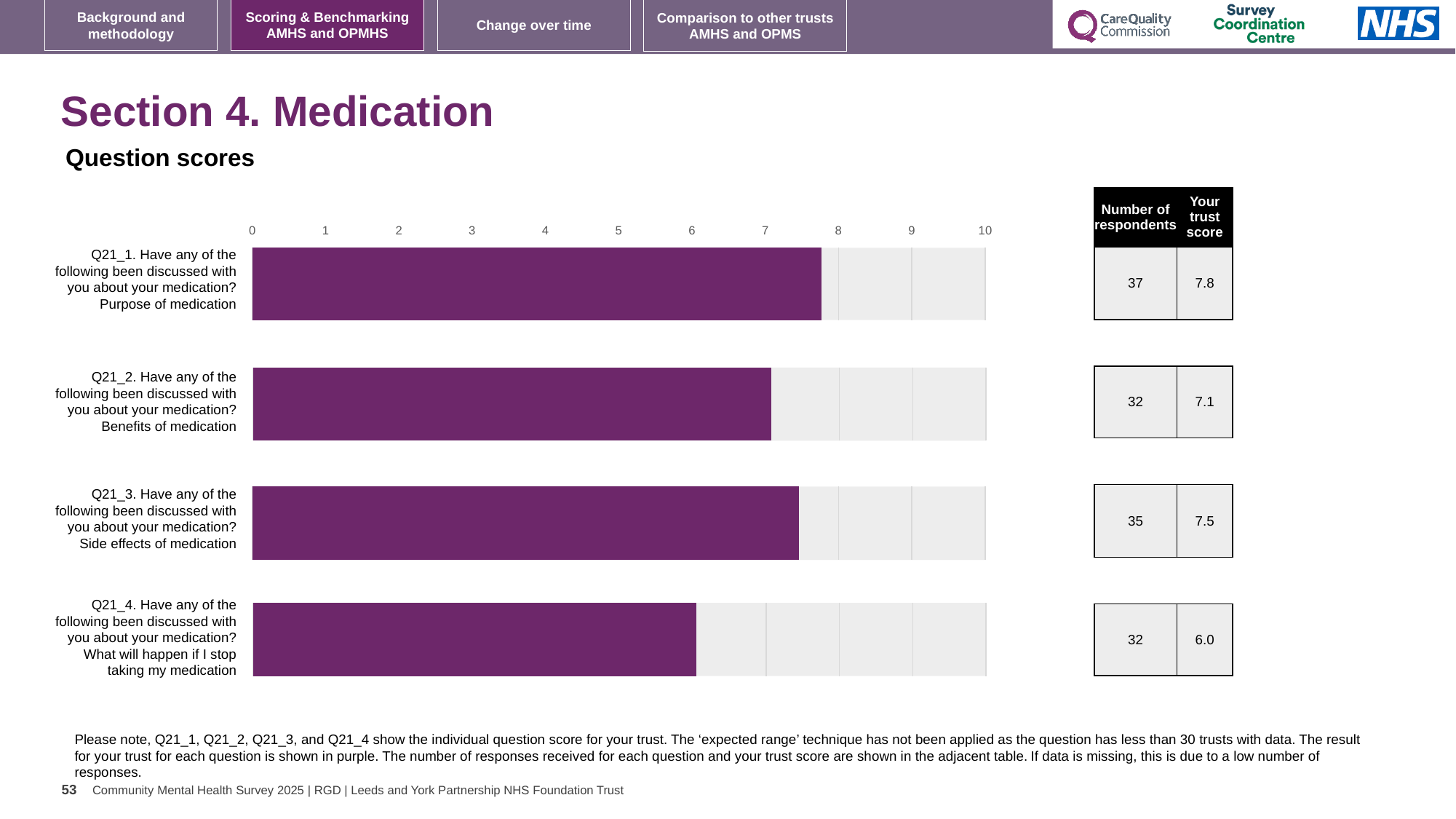
What is the difference between the trust scores for Q21_1 (Purpose of medication) and Q21_4 (What will happen if I stop taking my medication)? 1.8 Which question has the highest trust score? Q21_1. Purpose of medication What is the trust score for Q21_1 (Purpose of medication)? 7.8 How many respondents answered Q21_3 (Side effects of medication)? 35 How many questions are plotted in the chart? 4 Which question has the lowest trust score? Q21_4. What will happen if I stop taking my medication Is the bar for Q21_2 (Benefits of medication) greater or less than 8? less What kind of chart is shown on the slide? Bar chart What colour are the bars showing the trust's results? Purple Which has the larger trust score, Q21_2 (Benefits of medication) or Q21_3 (Side effects of medication)? Q21_3. Side effects of medication What is the maximum value shown on the chart's axis? 10 What is the trust score for Q21_4 (What will happen if I stop taking my medication)? 6.0